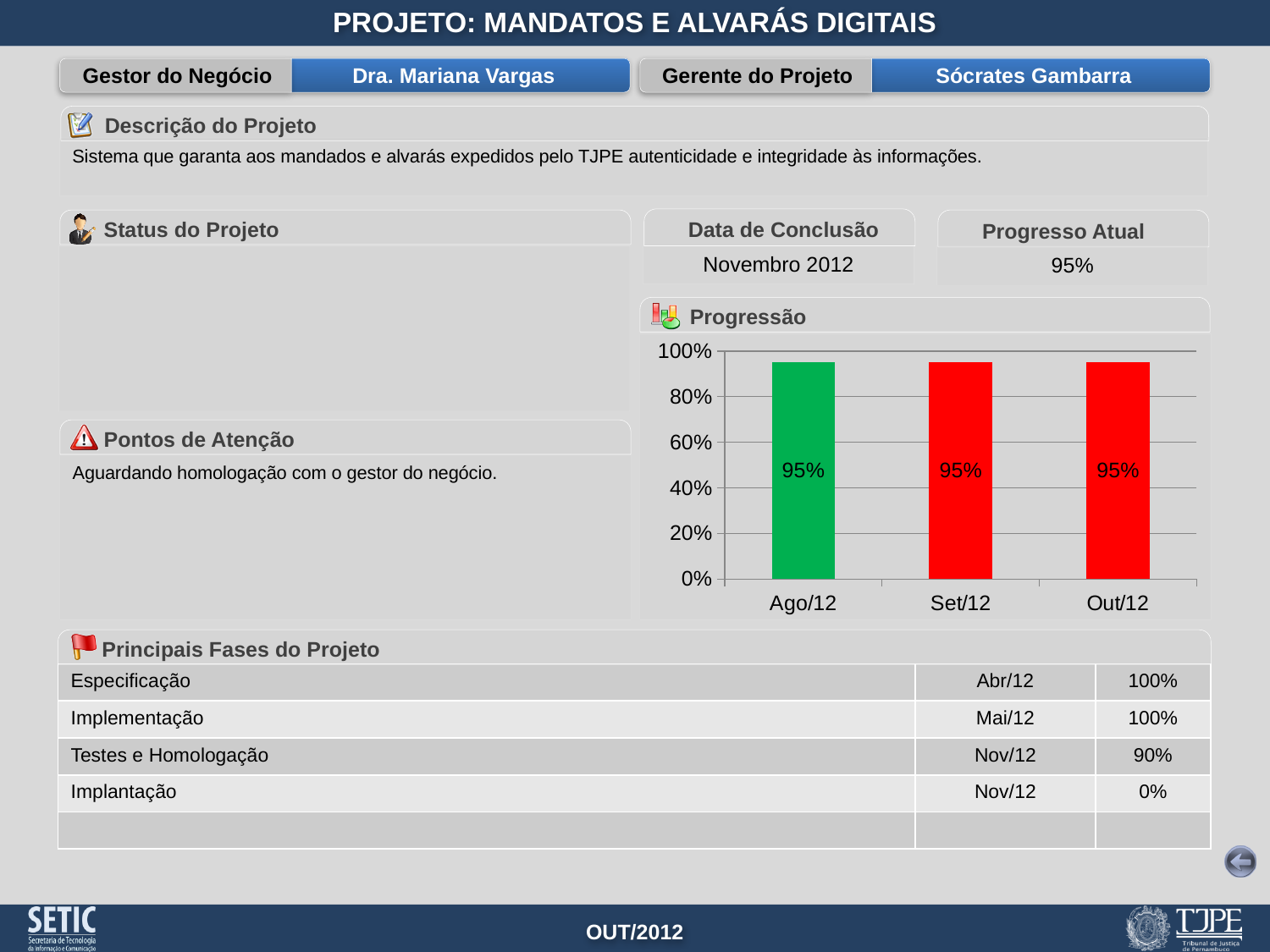
How many bars are plotted in the Progressão chart? 3 What is the value for Out/12 in the Progressão chart? 95% What colour is the Ago/12 bar in the Progressão chart? green Do the values in the Progressão chart rise, fall or stay flat from Ago/12 to Out/12? stay flat What is the highest value shown on the y axis of the Progressão chart? 100% What is the value for Ago/12 in the Progressão chart? 95% What is the value for Set/12 in the Progressão chart? 95% What kind of chart is the Progressão chart? bar chart What is the title of the bar chart on the slide? Progressão Is the value for Set/12 in the Progressão chart greater or less than 80%? greater Is the value for Ago/12 in the Progressão chart greater or less than 100%? less What is the difference between the values for Ago/12 and Out/12 in the Progressão chart? 0%